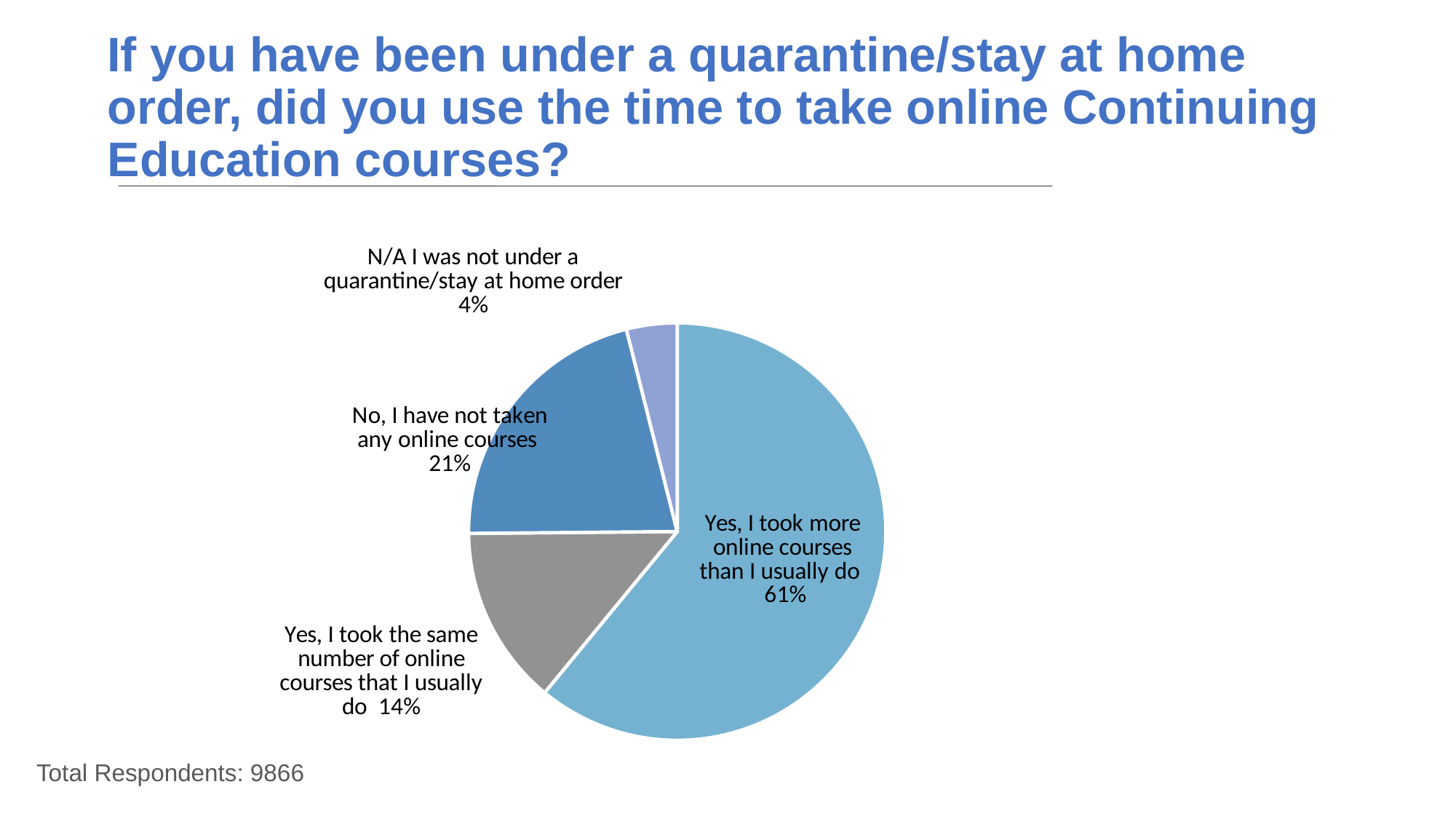
Which is larger: the share for "No, I have not taken any online courses" or the share for "Yes, I took the same number of online courses that I usually do"? No, I have not taken any online courses What share of respondents said "No, I have not taken any online courses"? 21% What is the difference in percentage points between "Yes, I took more online courses than I usually do" and "No, I have not taken any online courses"? 40 percentage points Which response has the largest share of the pie? Yes, I took more online courses than I usually do How many slices does the pie chart have? 4 What kind of chart is shown on the slide? pie chart Which response has the smallest share of the pie? N/A I was not under a quarantine/stay at home order How many total respondents are reported on the slide? 9866 What share of respondents said "N/A I was not under a quarantine/stay at home order"? 4% What is the combined share of the two "Yes" responses? 75% What share of respondents said "Yes, I took the same number of online courses that I usually do"? 14% What share of respondents said "Yes, I took more online courses than I usually do"? 61%